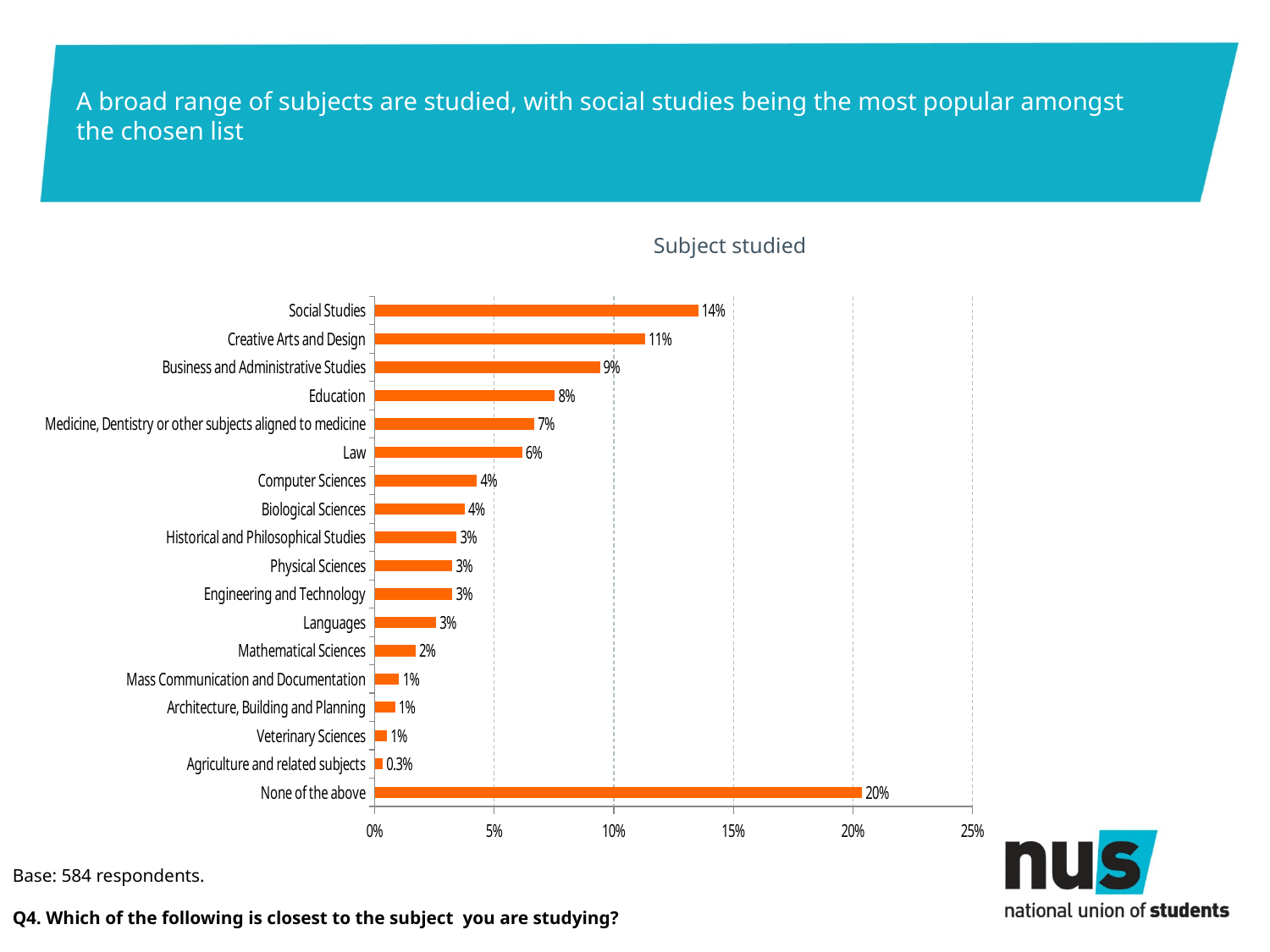
What is the value for Social Studies? 14% Which category has the lowest value? Agriculture and related subjects What is the value for None of the above? 20% What kind of chart is shown on the slide? Bar chart What is the title of the chart? Subject studied Is the value for Business and Administrative Studies greater or less than 10%? less What is the difference between the values for Social Studies and Creative Arts and Design? 3 percentage points Which is larger, the value for Education or the value for Law? Education How many categories are shown in the chart? 18 What is the value for Agriculture and related subjects? 0.3% What is the value for Law? 6% Which category has the highest value? None of the above